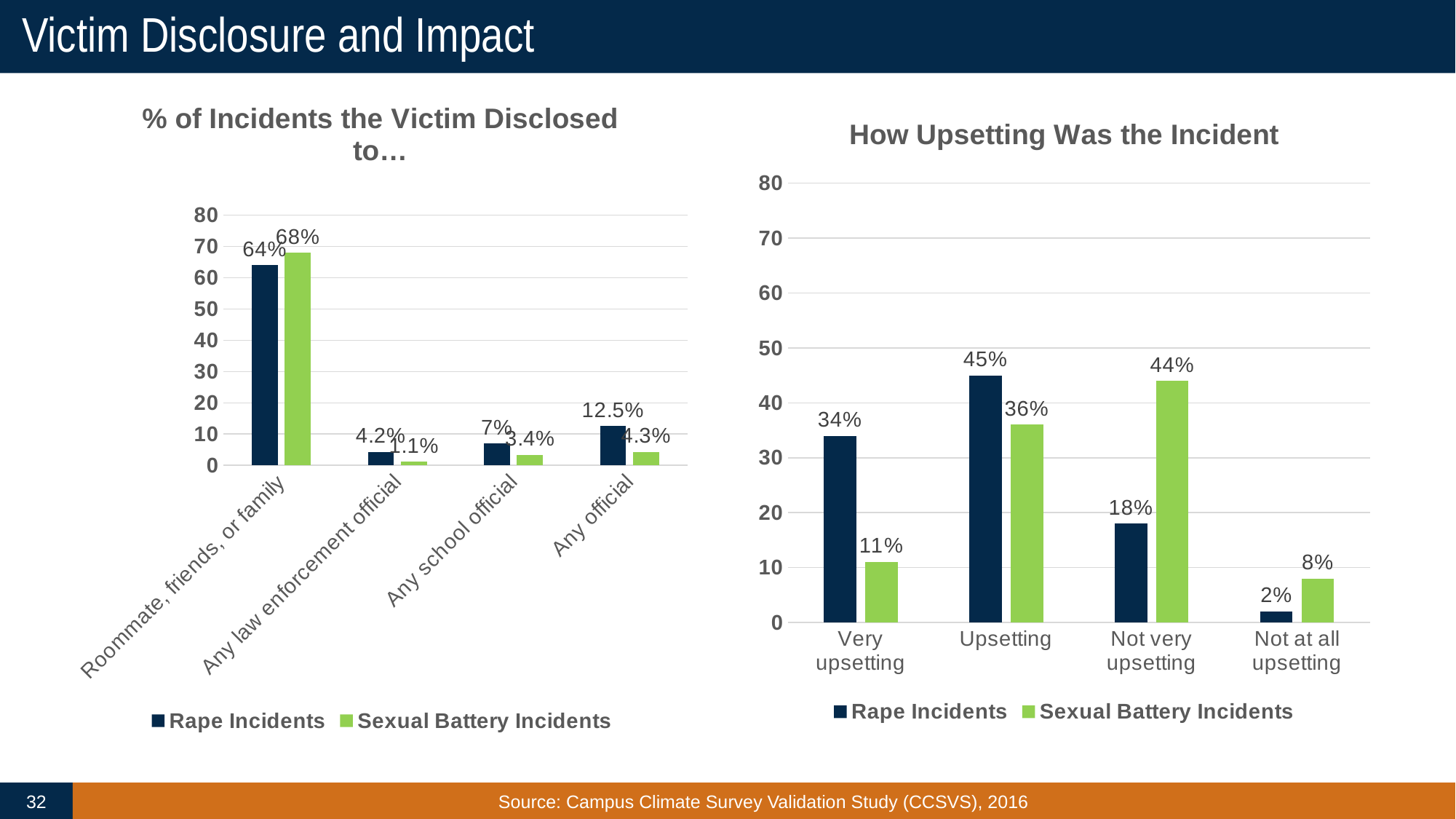
What kind of chart is the 'How Upsetting Was the Incident' chart? Bar chart In the '% of Incidents the Victim Disclosed to…' chart, which category has the highest value for Rape Incidents? Roommate, friends, or family How many series does the legend of the 'How Upsetting Was the Incident' chart list? 2 In the 'How Upsetting Was the Incident' chart, what is the difference between Rape Incidents and Sexual Battery Incidents for 'Very upsetting'? 23% In the 'How Upsetting Was the Incident' chart, what is the value for Sexual Battery Incidents for 'Not very upsetting'? 44% In the 'How Upsetting Was the Incident' chart, which category has the lowest value for Rape Incidents? Not at all upsetting In the '% of Incidents the Victim Disclosed to…' chart, what is the value for Rape Incidents for 'Roommate, friends, or family'? 64% In the 'How Upsetting Was the Incident' chart, what is the value for Rape Incidents for 'Upsetting'? 45% In the 'How Upsetting Was the Incident' chart, which is larger for 'Very upsetting': Rape Incidents or Sexual Battery Incidents? Rape Incidents In the '% of Incidents the Victim Disclosed to…' chart, what is the difference between Rape Incidents and Sexual Battery Incidents for 'Any official'? 8.2% In the '% of Incidents the Victim Disclosed to…' chart, what is the value for Sexual Battery Incidents for 'Any law enforcement official'? 1.1% In the '% of Incidents the Victim Disclosed to…' chart, how many categories are shown on the x axis? 4